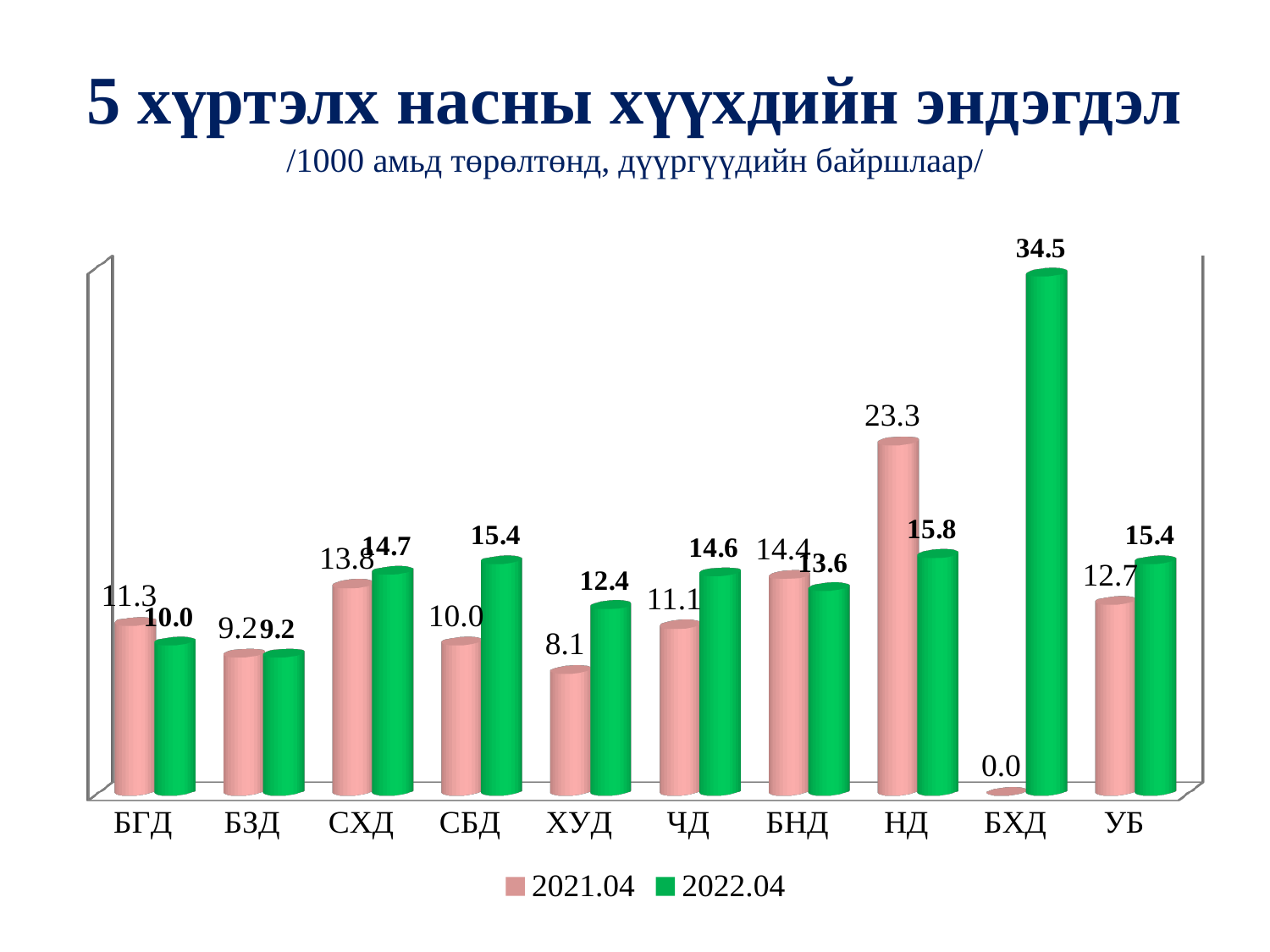
What is the value for НД in the 2021.04 series? 23.3 Which colour represents the 2022.04 series? Green Which category has the highest value in the 2022.04 series? БХД Which is larger for БНД: the 2021.04 value or the 2022.04 value? 2021.04 What kind of chart is shown on the slide? Bar chart Which category has the lowest value in the 2021.04 series? БХД What is the value for БХД in the 2022.04 series? 34.5 How many categories are shown on the x axis? 10 What is the value for ХУД in the 2021.04 series? 8.1 What is the value for УБ in the 2022.04 series? 15.4 How many series does the legend list? 2 What is the difference between the 2022.04 and 2021.04 values for СБД? 5.4